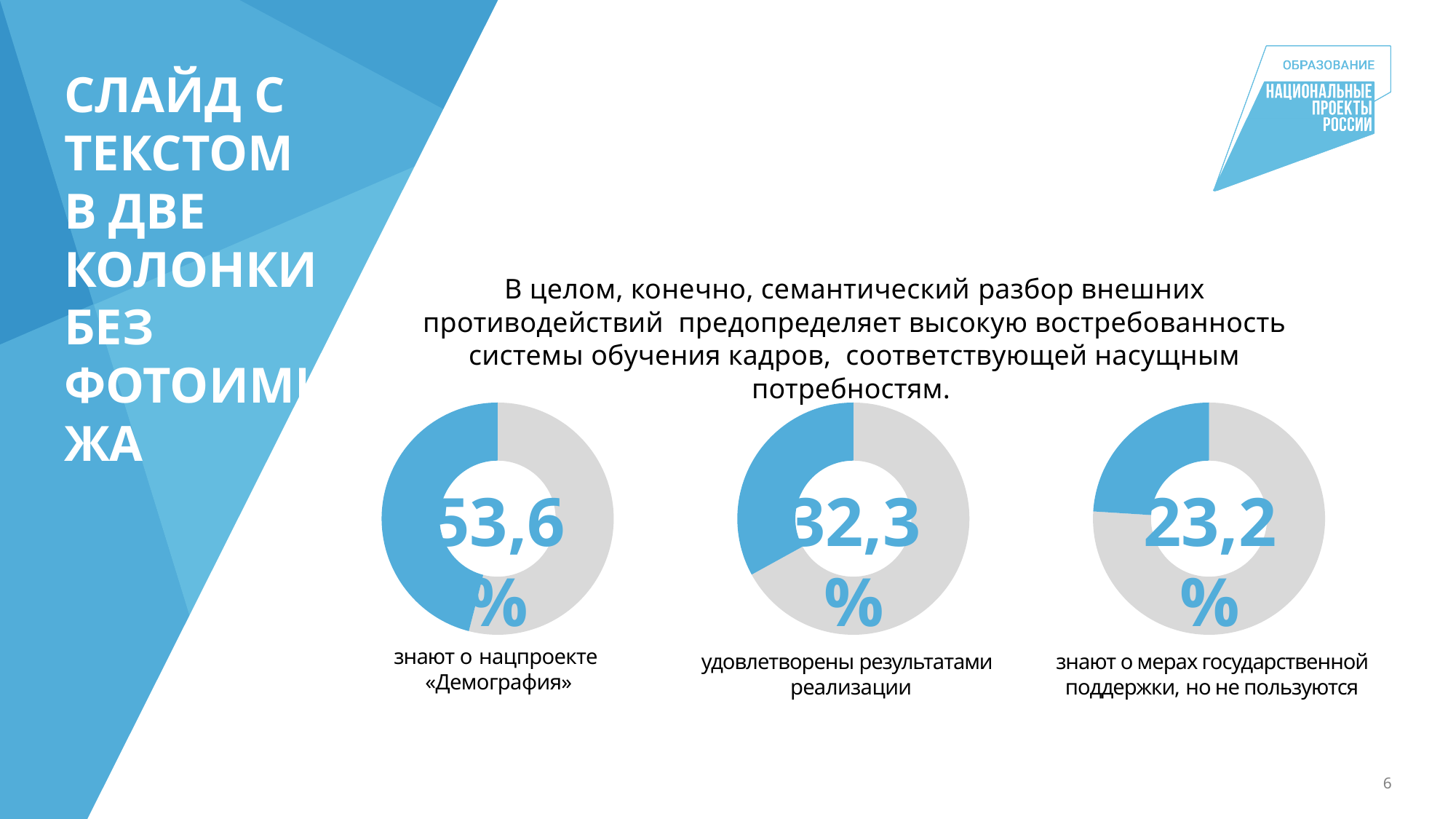
Is the value in the left donut chart greater or less than 50%? greater Which of the three donut charts shows the lowest percentage? знают о мерах государственной поддержки, но не пользуются (23,2%) What is the difference between the percentage in the left donut chart and the percentage in the right donut chart? 30,4% What percentage is shown in the middle donut chart, labelled «удовлетворены результатами реализации»? 32,3% How many donut charts are on the slide? 3 What percentage is shown in the right donut chart, labelled «знают о мерах государственной поддержки, но не пользуются»? 23,2% Which of the three donut charts shows the highest percentage? знают о нацпроекте «Демография» (53,6%) What is the difference between the percentage in the middle donut chart and the percentage in the right donut chart? 9,1% What kind of charts are shown on the slide? donut (pie) charts What colour is the highlighted slice in each donut chart? blue What percentage is shown in the left donut chart, labelled «знают о нацпроекте «Демография»»? 53,6% Which is larger: the percentage in the middle donut chart or the percentage in the right donut chart? the middle chart (32,3%)